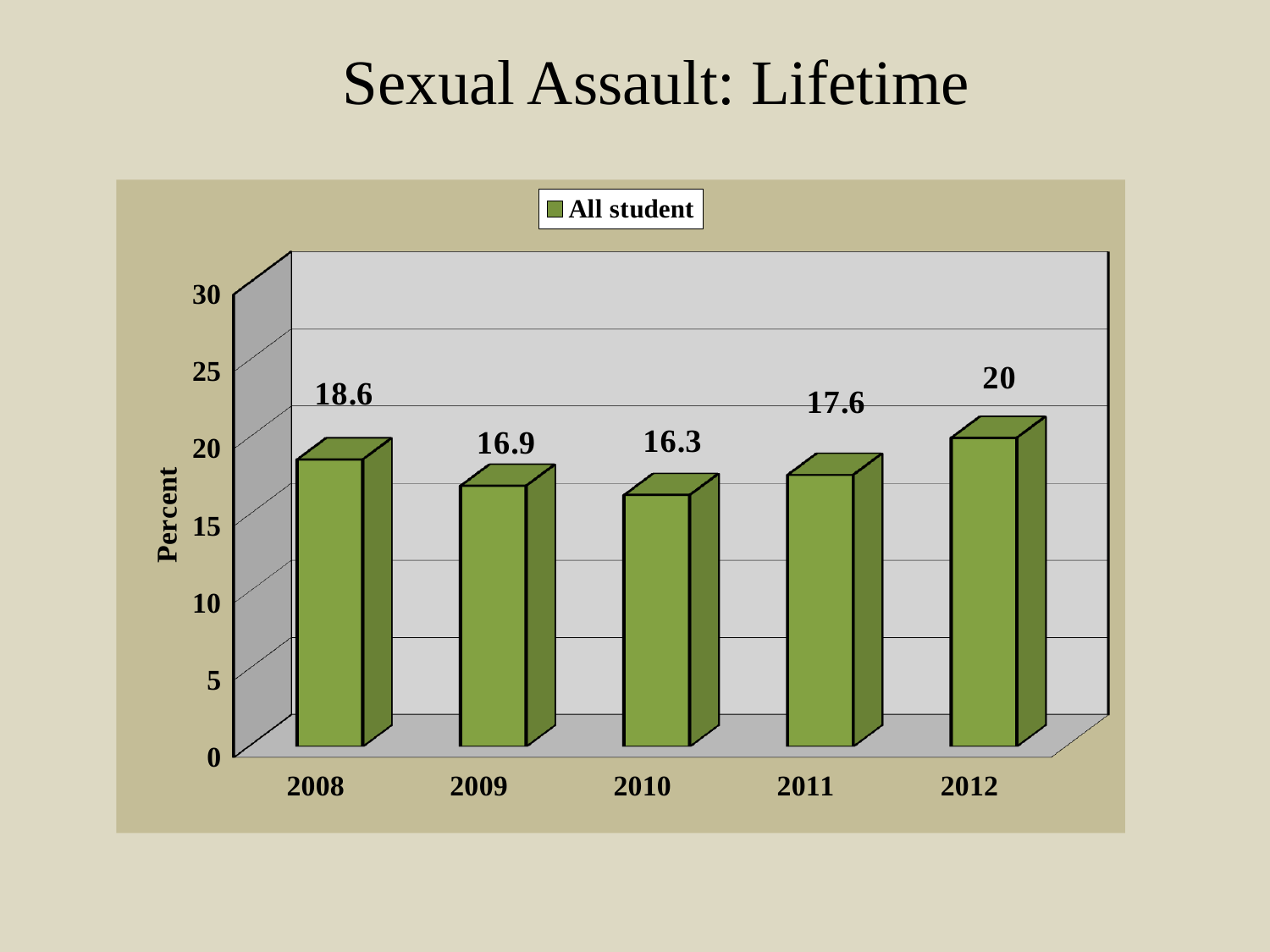
What is the difference between the values for 2012 and 2010? 3.7 What is the title of the chart? Sexual Assault: Lifetime What kind of chart is shown? bar chart Is the value for 2011 greater or less than 20? less What is the value for 2012? 20 Which year has the lowest value? 2010 Which is larger, the value for 2011 or the value for 2009? 2011 How many years are shown on the x axis? 5 Which year has the highest value? 2012 What is the difference between the values for 2008 and 2009? 1.7 What is the value for 2010? 16.3 What is the value for 2008? 18.6